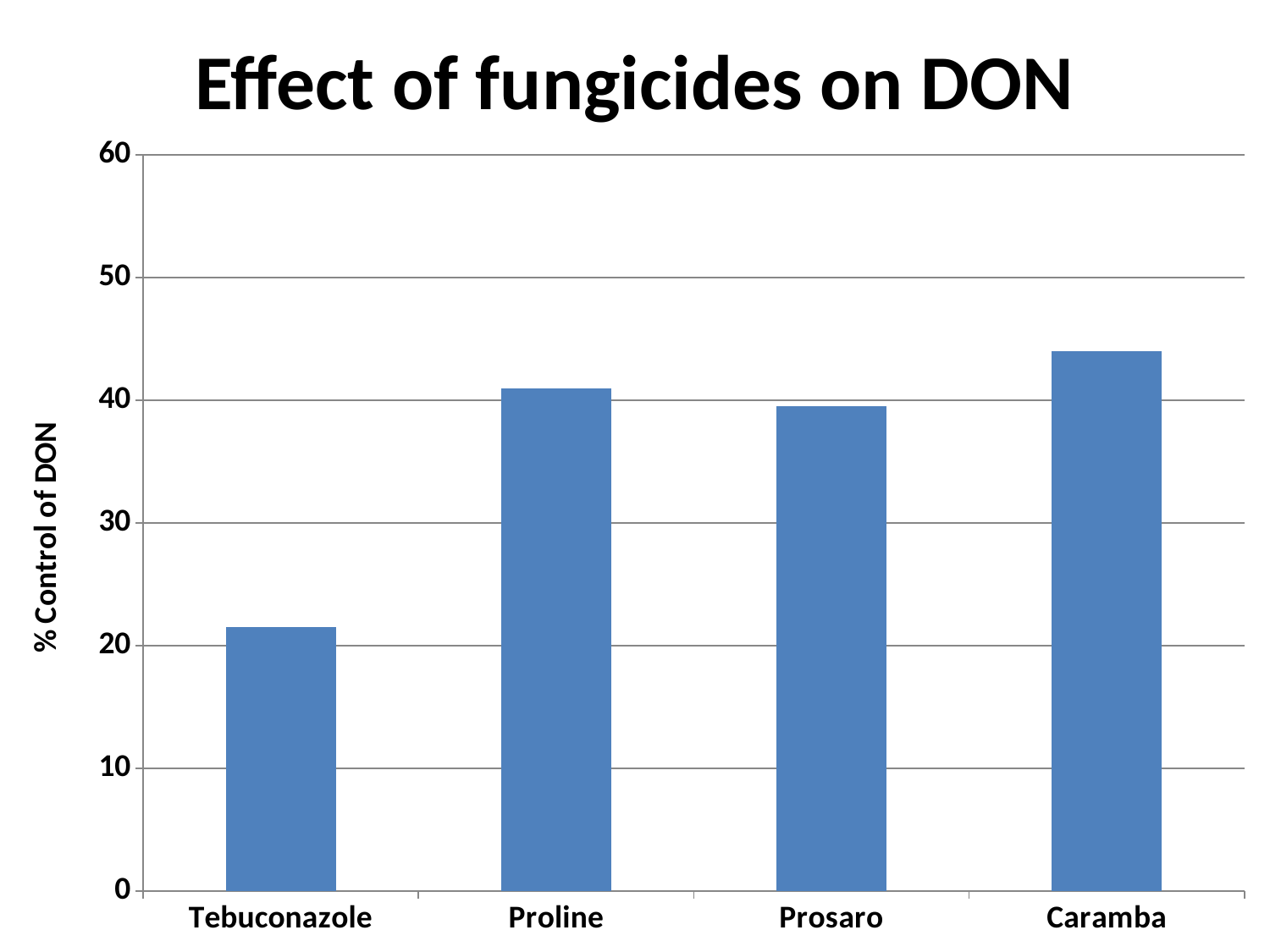
Which fungicide has the highest % control of DON? Caramba Which has a higher % control of DON, Prosaro or Caramba? Caramba Is the value for Tebuconazole greater or less than 30? less Which fungicide has the lowest % control of DON? Tebuconazole Is the value for Proline greater or less than 40? greater Which has a higher % control of DON, Tebuconazole or Proline? Proline Is the value for Caramba greater or less than 50? less What kind of chart is shown on the slide? bar chart What is the label of the vertical axis? % Control of DON What is the title of the chart? Effect of fungicides on DON How many fungicides are shown on the x axis? 4